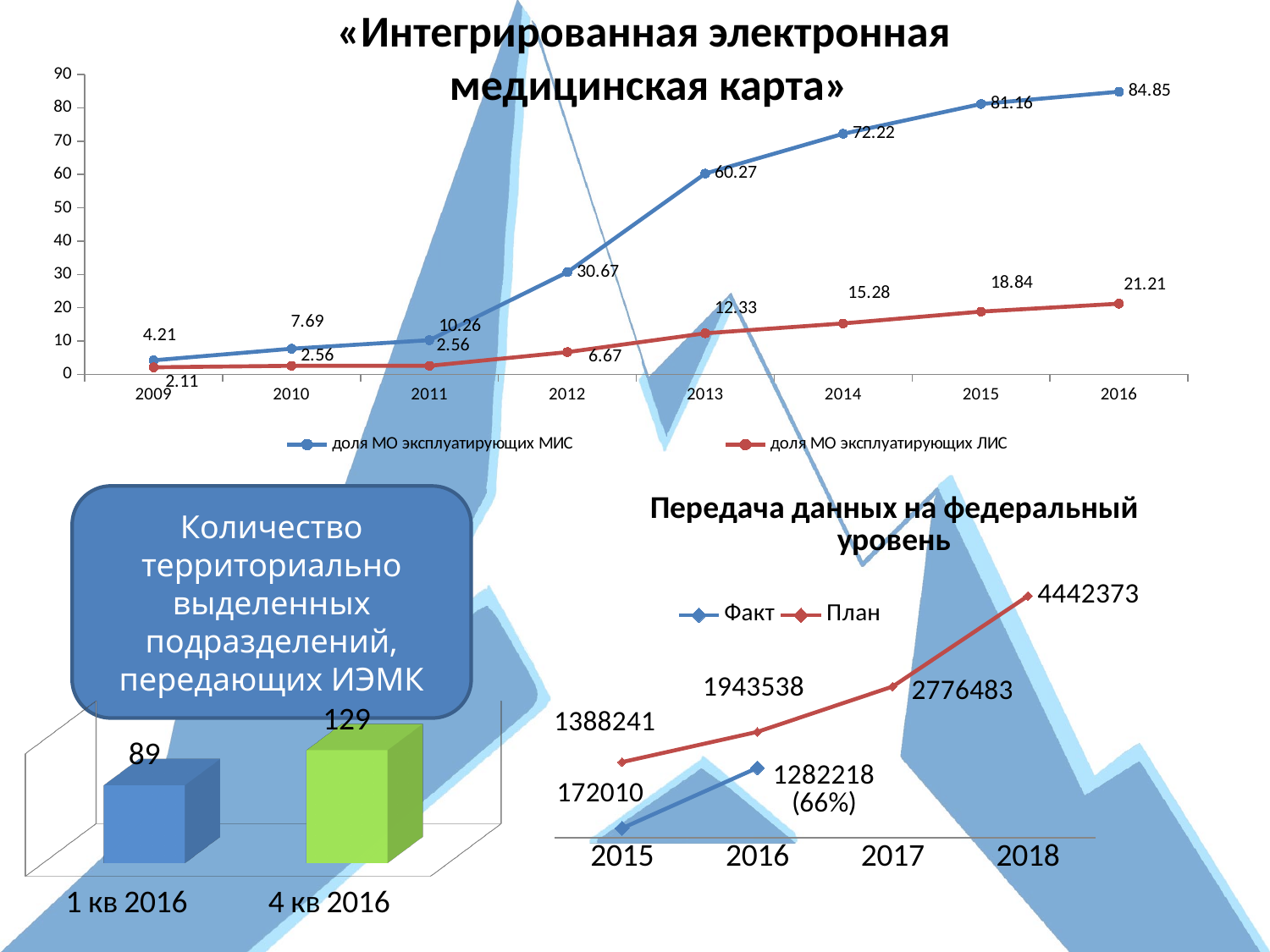
In the top chart «Интегрированная электронная медицинская карта», does доля МО эксплуатирующих МИС rise or fall from 2009 to 2016? rise In the top chart «Интегрированная электронная медицинская карта», what is the value of доля МО эксплуатирующих ЛИС in 2013? 12.33 In the bottom-right chart «Передача данных на федеральный уровень», which is larger in 2016: Факт or План? План In the top chart «Интегрированная электронная медицинская карта», what is the value of доля МО эксплуатирующих МИС in 2016? 84.85 In the top chart «Интегрированная электронная медицинская карта», what is the difference between доля МО эксплуатирующих МИС and доля МО эксплуатирующих ЛИС in 2014? 56.94 What kind of chart is the bottom-left chart «Количество территориально выделенных подразделений, передающих ИЭМК»? bar chart In the bottom-left chart «Количество территориально выделенных подразделений, передающих ИЭМК», what is the difference between 4 кв 2016 and 1 кв 2016? 40 In the top chart «Интегрированная электронная медицинская карта», how many years are shown on the x axis? 8 In the top chart «Интегрированная электронная медицинская карта», in which year is доля МО эксплуатирующих МИС lowest? 2009 In the bottom-left chart «Количество территориально выделенных подразделений, передающих ИЭМК», what is the value for 4 кв 2016? 129 In the top chart «Интегрированная электронная медицинская карта», how many series does the legend list? 2 In the bottom-right chart «Передача данных на федеральный уровень», what is the План value for 2018? 4442373